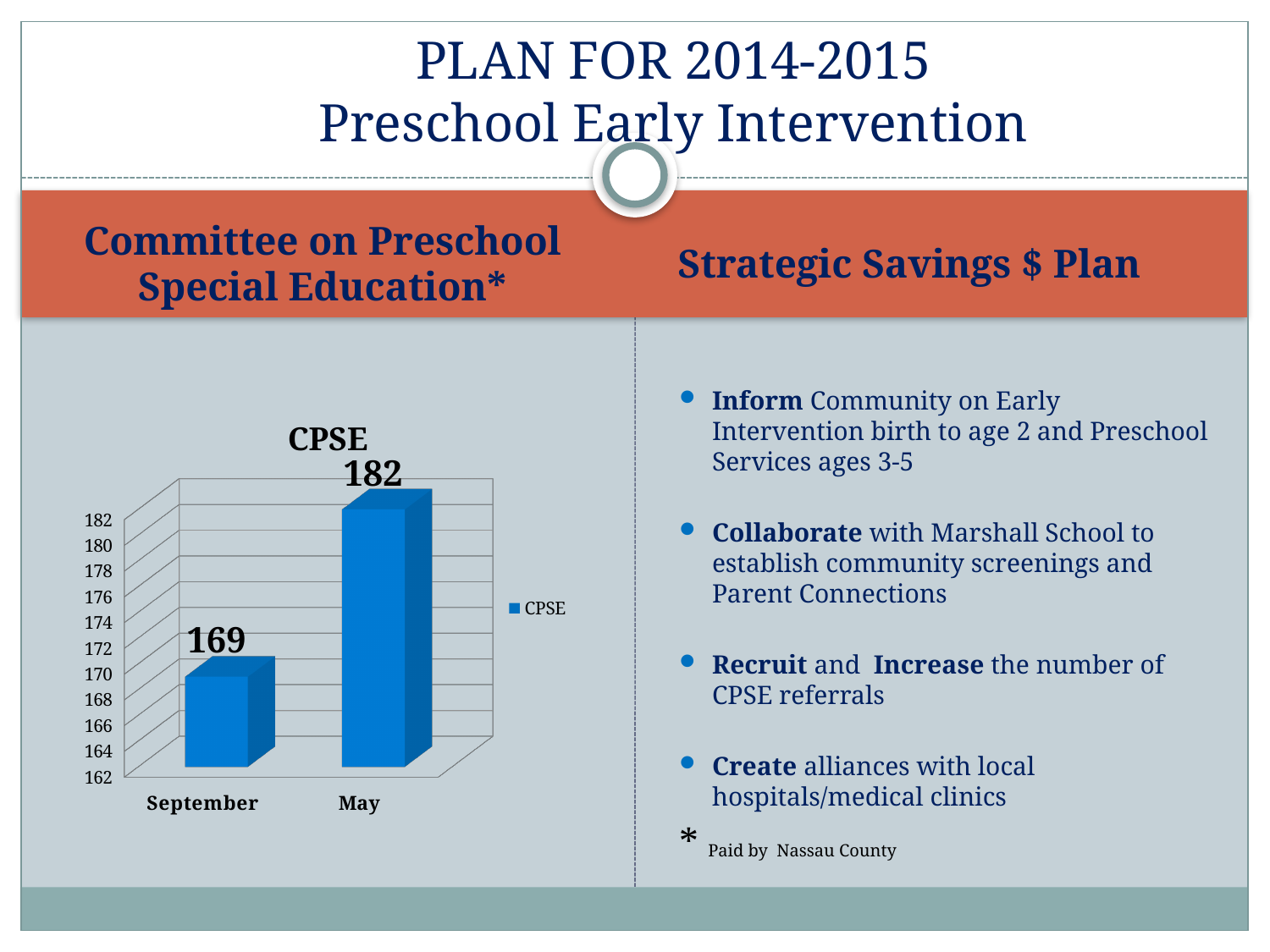
What kind of chart is shown on the slide? bar chart What is the CPSE value for May? 182 Is the CPSE value for May greater or less than 180? greater What is the difference between the May and September CPSE values? 13 Which category has the lowest CPSE value? September How many categories are shown on the x axis of the chart? 2 What is the title of the chart? CPSE Is the CPSE value for September greater or less than 170? less Which category has the highest CPSE value? May Which is larger, the CPSE value for September or for May? May How many series does the chart legend list? 1 What is the CPSE value for September? 169